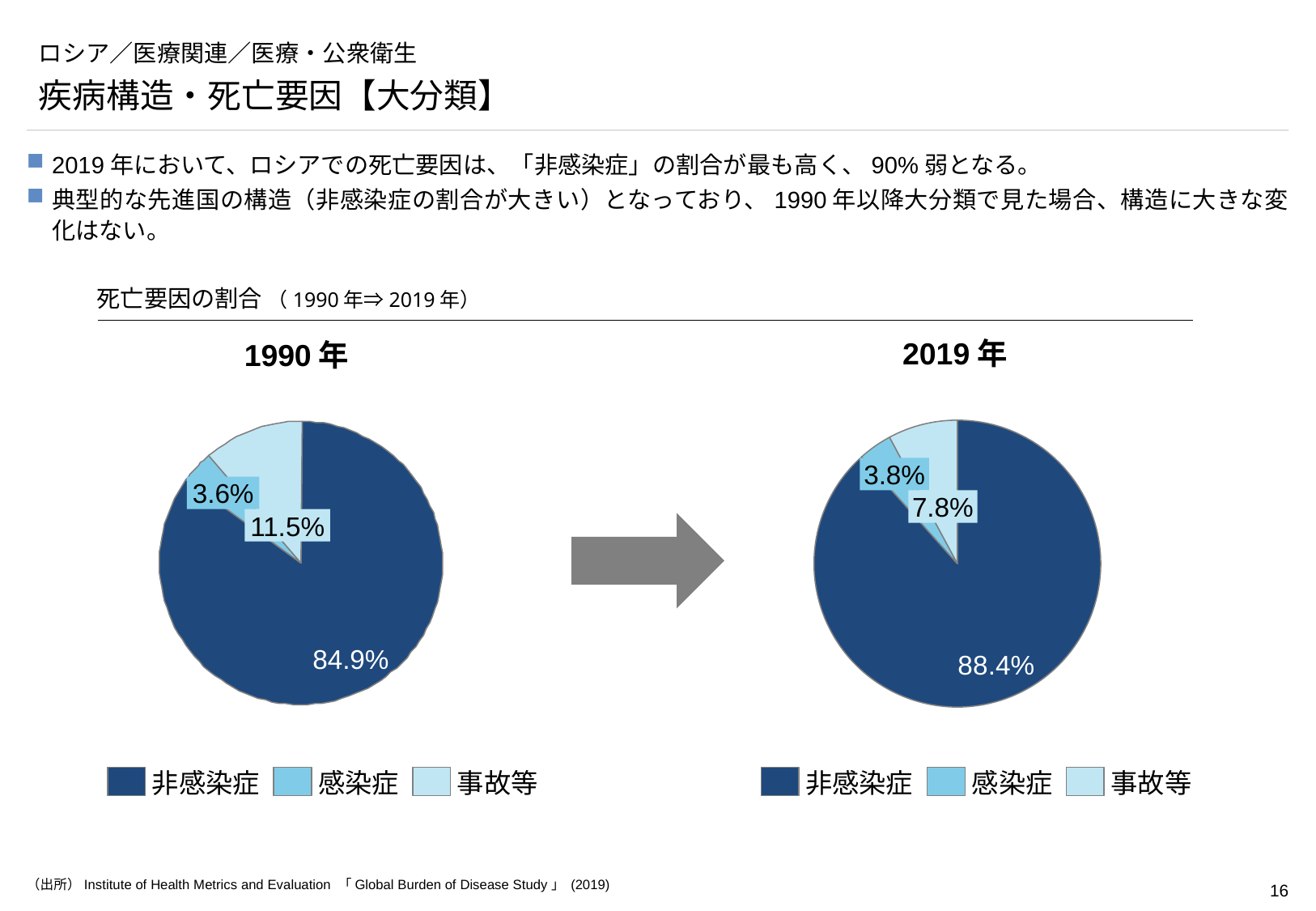
In the 2019年 pie chart, what is the share for 非感染症? 88.4% What type of chart is used for the 2019年 data? Pie chart In the 2019年 pie chart, what is the share for 事故等? 7.8% What is the difference between the 事故等 share in the 1990年 pie chart and in the 2019年 pie chart? 3.7% Is the 非感染症 share larger in the 1990年 pie chart or the 2019年 pie chart? 2019年 In the 1990年 pie chart, what is the share for 感染症? 3.6% In the 1990年 pie chart, what is the share for 非感染症? 84.9% In the 2019年 pie chart, which category has the smallest share? 感染症 How many categories does the 1990年 pie chart show? 3 In the 1990年 pie chart, which category has the largest share? 非感染症 In the 2019年 pie chart, what is the combined share of 感染症 and 事故等? 11.6% Which category is shown in the darkest blue in the legend of the 1990年 pie chart? 非感染症